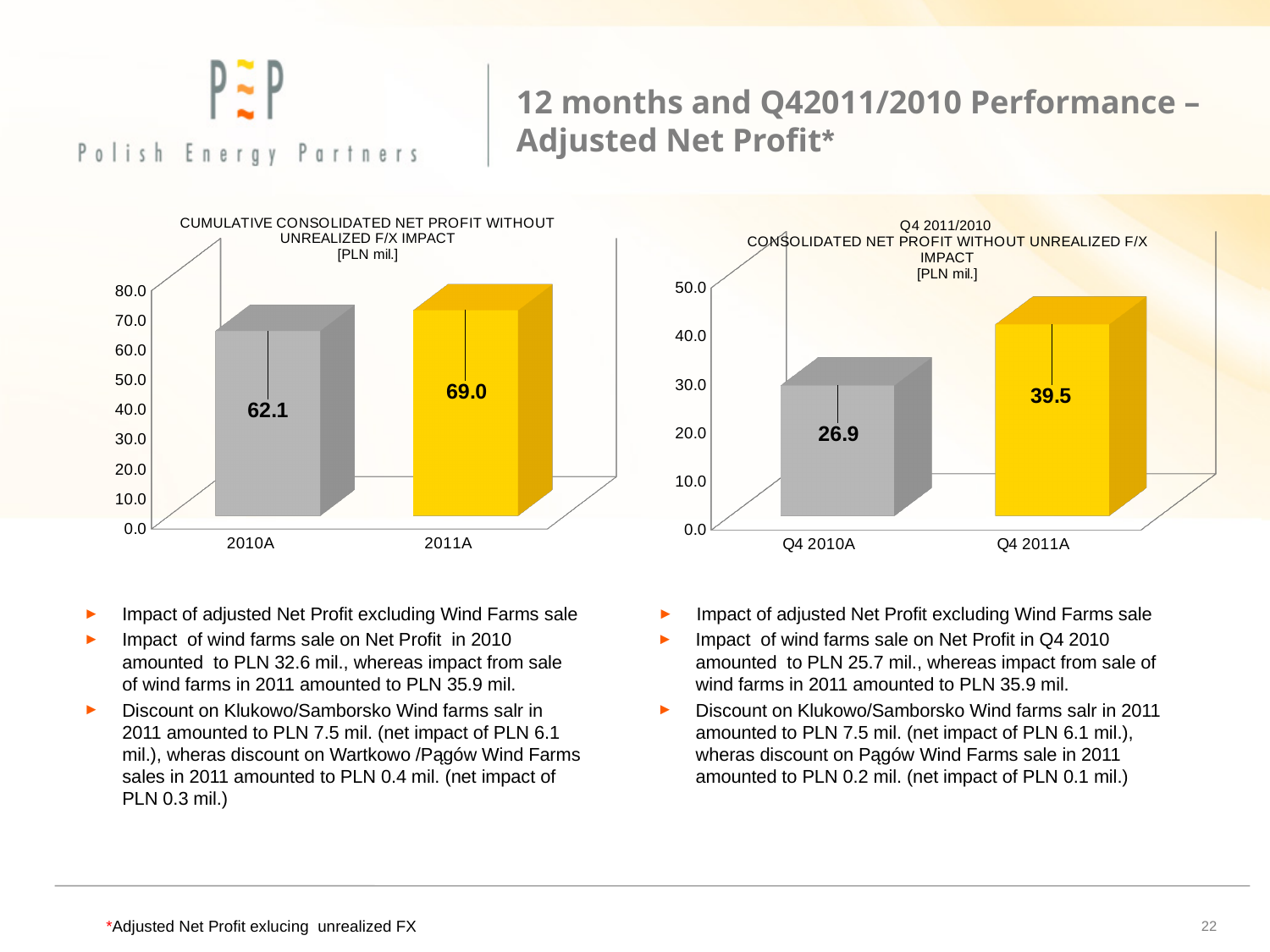
In the right chart (Q4 2011/2010 Consolidated Net Profit Without Unrealized F/X Impact), what is the value for Q4 2010A? 26.9 In the left chart (Cumulative Consolidated Net Profit Without Unrealized F/X Impact), what is the value for 2010A? 62.1 In the left chart (Cumulative Consolidated Net Profit Without Unrealized F/X Impact), what is the value for 2011A? 69.0 In the right chart, what is the difference between the Q4 2011A and Q4 2010A values? 12.6 In the right chart, is the value for Q4 2010A greater or less than 30.0? less In the right chart, which quarter has the lower value? Q4 2010A In the left chart, do the values rise or fall from 2010A to 2011A? Rise How many categories are shown in the left chart? 2 In the left chart, which year has the higher cumulative net profit? 2011A In the left chart, what is the difference between the 2011A and 2010A values? 6.9 What type of chart is the right chart? Bar chart In the right chart (Q4 2011/2010 Consolidated Net Profit Without Unrealized F/X Impact), what is the value for Q4 2011A? 39.5